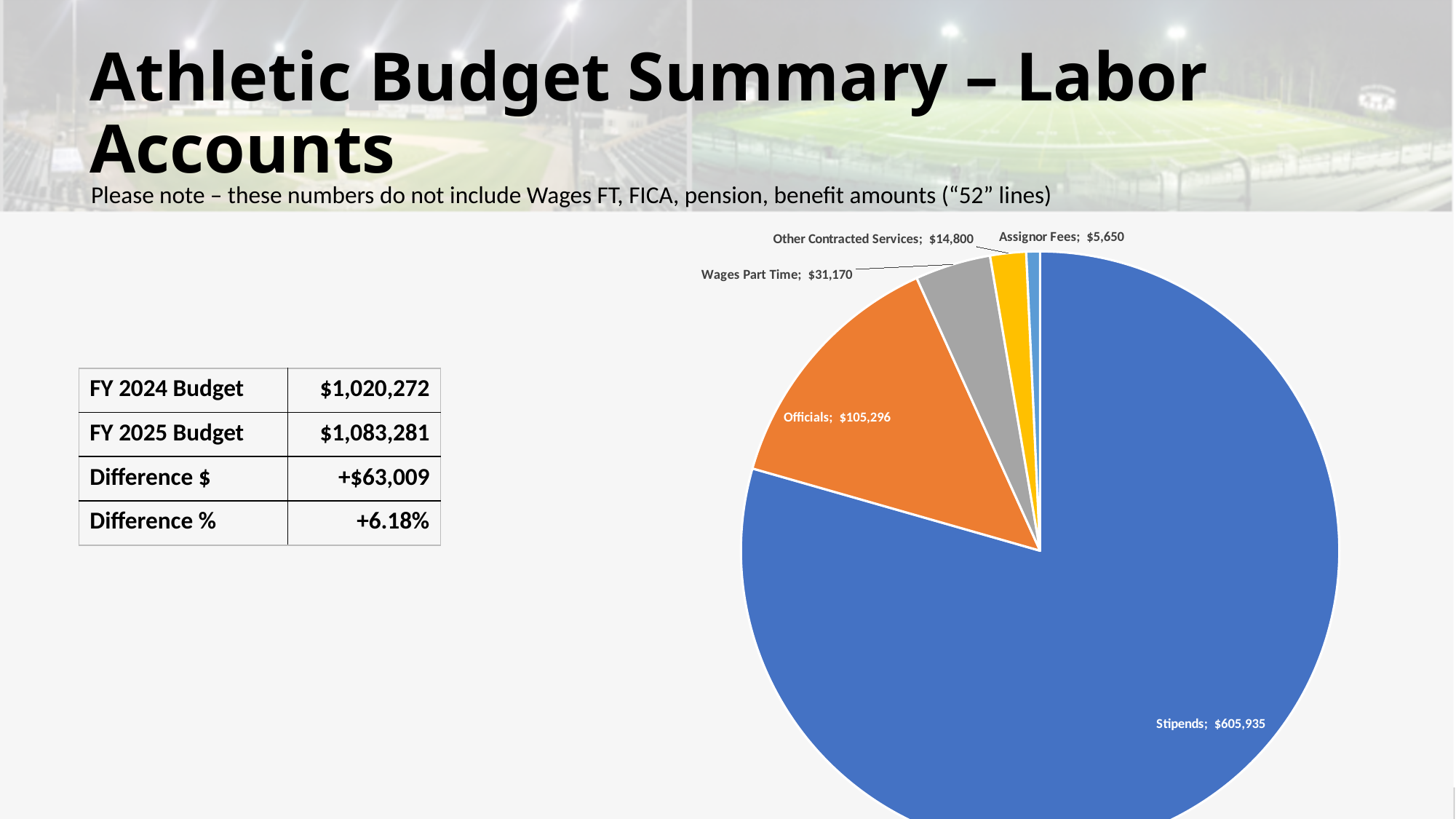
What kind of chart is shown on the slide? Pie chart Which category has the smallest slice in the pie chart? Assignor Fees How many slices does the pie chart have? 5 What is the value for Assignor Fees in the pie chart? $5,650 Which category has the largest slice in the pie chart? Stipends What is the difference between the Stipends value and the Officials value in the pie chart? $500,639 What is the value for Wages Part Time in the pie chart? $31,170 What is the value for Other Contracted Services in the pie chart? $14,800 What colour is the Officials slice in the pie chart? Orange What is the value of the Stipends slice in the pie chart? $605,935 Which is larger in the pie chart, Wages Part Time or Other Contracted Services? Wages Part Time What is the value of the Officials slice in the pie chart? $105,296